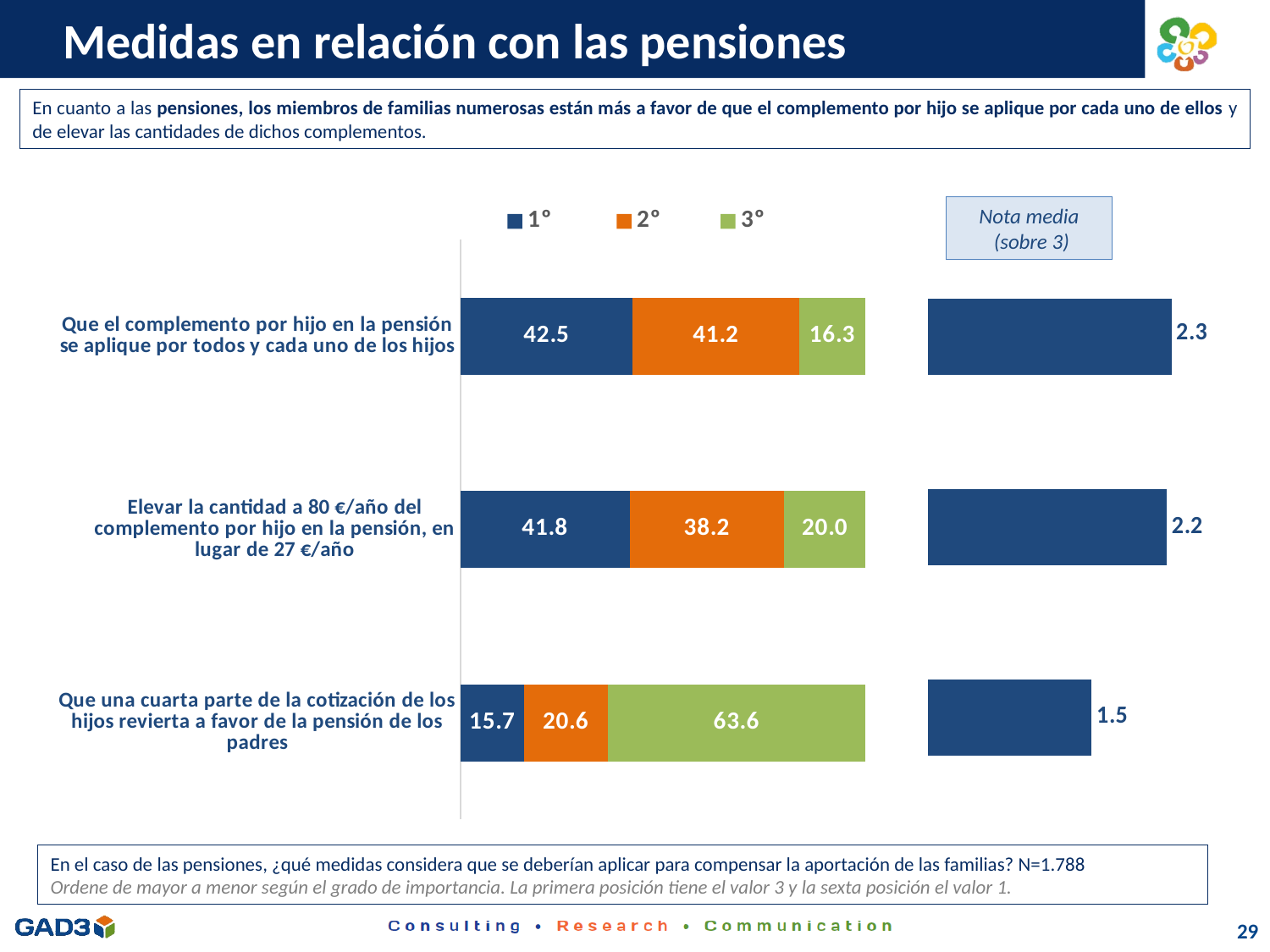
In the stacked bar chart on the left, which measure has the lowest value for 1°? Que una cuarta parte de la cotización de los hijos revierta a favor de la pensión de los padres In the stacked bar chart on the left, which is larger for 'Elevar la cantidad a 80 €/año del complemento por hijo en la pensión, en lugar de 27 €/año': the 1° value or the 2° value? 1° In the 'Nota media (sobre 3)' chart on the right, which measure has the highest value? Que el complemento por hijo en la pensión se aplique por todos y cada uno de los hijos In the stacked bar chart on the left, what is the difference between the 3° value for 'Que una cuarta parte de la cotización de los hijos revierta a favor de la pensión de los padres' and the 3° value for 'Que el complemento por hijo en la pensión se aplique por todos y cada uno de los hijos'? 47.3 In the stacked bar chart on the left, what is the value for 1° for 'Que el complemento por hijo en la pensión se aplique por todos y cada uno de los hijos'? 42.5 In the stacked bar chart on the left, what is the value for 3° for 'Elevar la cantidad a 80 €/año del complemento por hijo en la pensión, en lugar de 27 €/año'? 20.0 How many measures (categories) are shown in the stacked bar chart on the left? 3 In the stacked bar chart on the left, what is the value for 2° for 'Que una cuarta parte de la cotización de los hijos revierta a favor de la pensión de los padres'? 20.6 In the 'Nota media (sobre 3)' chart on the right, what is the value for 'Que una cuarta parte de la cotización de los hijos revierta a favor de la pensión de los padres'? 1.5 In the 'Nota media (sobre 3)' chart on the right, what is the difference between the values for 'Que el complemento por hijo en la pensión se aplique por todos y cada uno de los hijos' and 'Que una cuarta parte de la cotización de los hijos revierta a favor de la pensión de los padres'? 0.8 How many series does the legend of the stacked bar chart on the left list? 3 What kind of chart is the chart on the left? Stacked bar chart